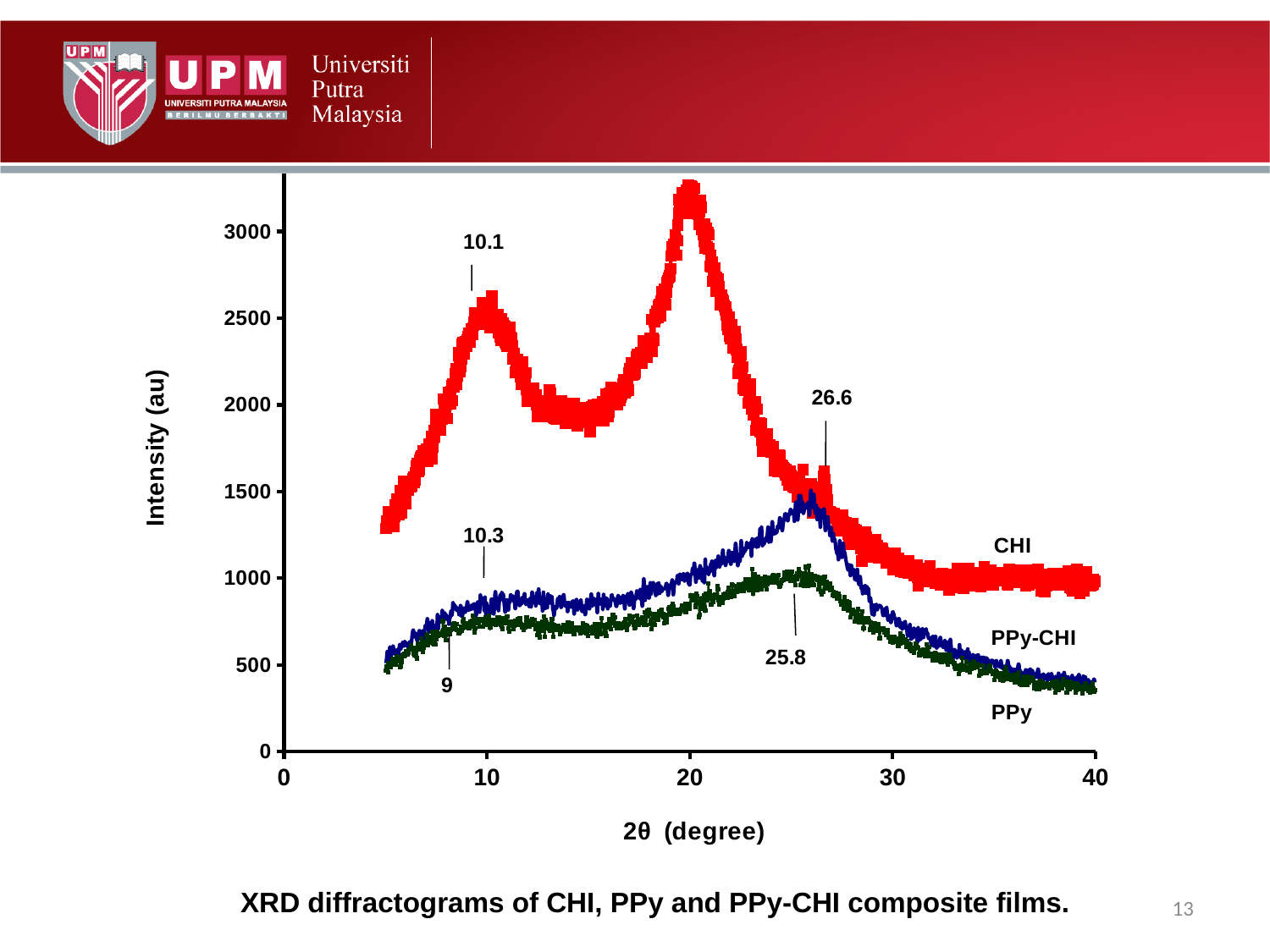
Does the CHI curve rise or fall as 2θ increases from 20 to 40? fall At what 2θ value is the labelled peak of the PPy-CHI curve? 10.3 Is the intensity of the PPy-CHI curve at 2θ = 10 greater or less than 1000? less What is the label of the y axis? Intensity (au) How many curves (series) are labelled on the chart? 3 At what 2θ value is the labelled peak of the PPy curve near 25? 25.8 At 2θ = 30, which curve has the higher intensity, CHI or PPy? CHI Which series reaches the highest intensity on the chart? CHI At what 2θ value is the second labelled peak of the CHI curve? 26.6 What kind of chart is shown on the slide? line chart At what 2θ value is the first labelled peak of the CHI curve? 10.1 Is the maximum intensity of the CHI curve greater or less than 3000? greater